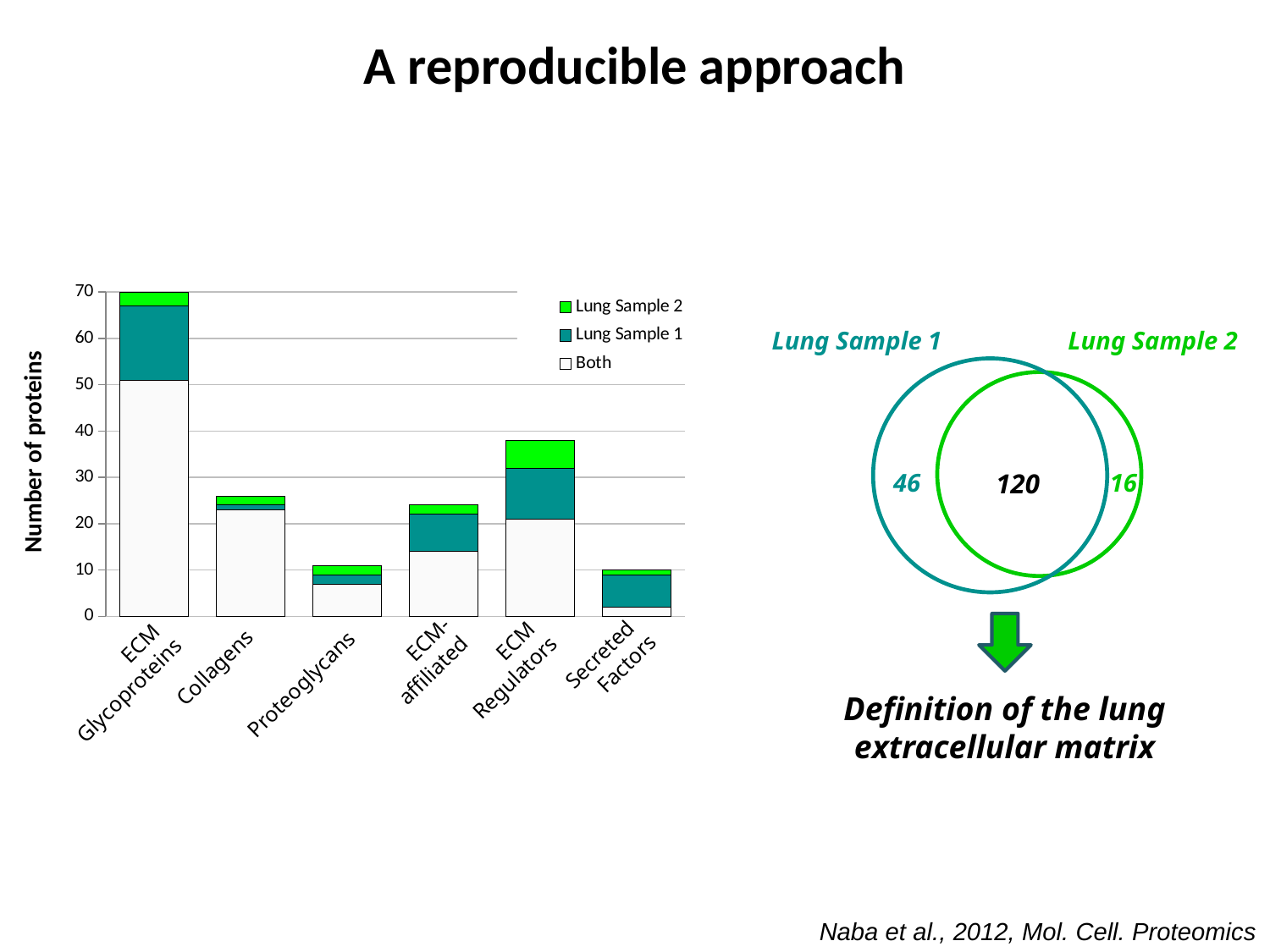
What kind of chart is shown on the left of the slide? stacked bar chart How many series does the legend of the bar chart list? 3 Is the total number of proteins for ECM Regulators greater or less than 30? greater Is the total number of proteins for Secreted Factors greater or less than 20? less What is the label of the y axis of the bar chart? Number of proteins Is the total number of proteins for Proteoglycans greater or less than 20? less Which legend entry of the bar chart is shown in white? Both What is the total number of proteins for ECM Glycoproteins in the bar chart? 70 Which category has the highest total number of proteins in the bar chart? ECM Glycoproteins How many protein categories are shown on the x axis of the bar chart? 6 Which has a larger total number of proteins, ECM Regulators or Collagens? ECM Regulators